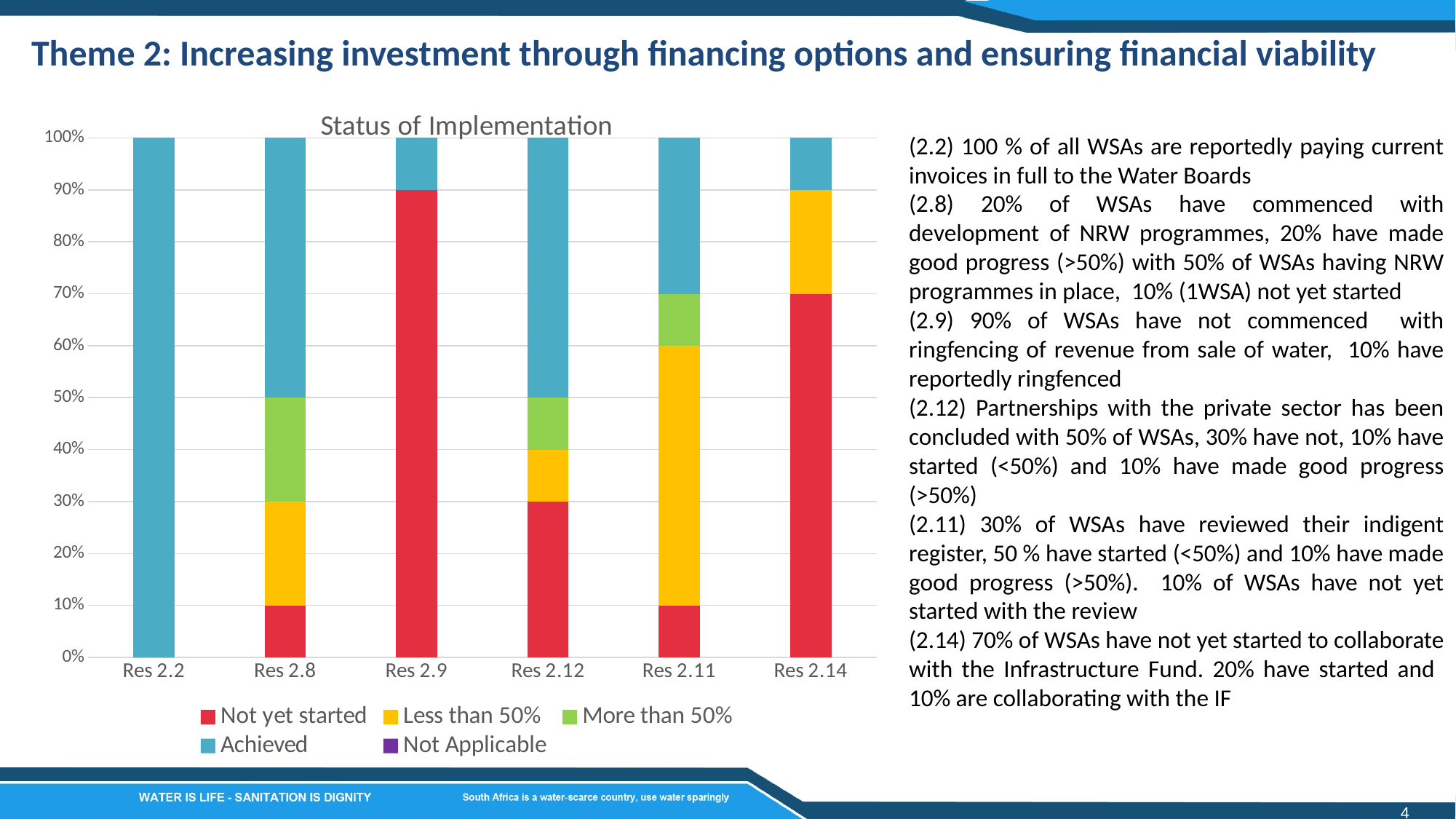
Which resolution has the largest 'Less than 50%' segment? Res 2.11 How many categories (resolutions) are shown on the x axis of the chart? 6 What is the 'Not yet started' value for Res 2.9? 90% What is the 'Not yet started' value for Res 2.14? 70% What is the 'Less than 50%' value for Res 2.11? 50% Which resolution has the largest 'Not yet started' segment? Res 2.9 What type of chart is shown on the slide? Stacked bar chart Is the 'Not yet started' value for Res 2.12 greater or less than 50%? less How many series does the chart legend list? 5 What is the 'Achieved' value for Res 2.2? 100% What is the title of the chart? Status of Implementation Which has the larger 'Achieved' segment, Res 2.8 or Res 2.14? Res 2.8